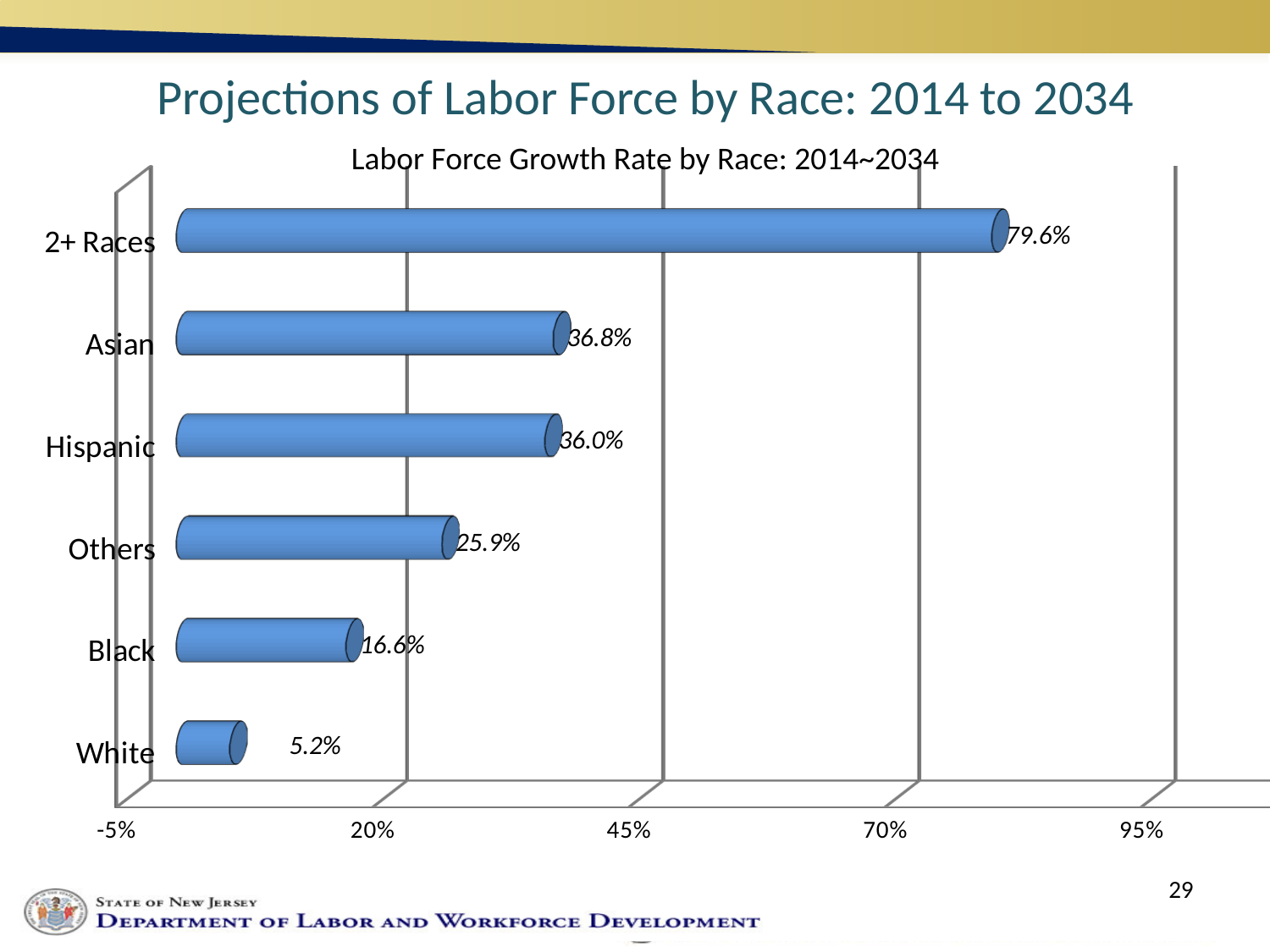
Which race category has the lowest labor force growth rate? White What is the labor force growth rate for Asian? 36.8% How many race categories are shown in the chart? 6 What kind of chart is shown on the slide? Bar chart What is the title of the chart? Labor Force Growth Rate by Race: 2014~2034 Which race category has the highest labor force growth rate? 2+ Races What is the labor force growth rate for White? 5.2% What is the difference between the growth rates for Others and Black? 9.3% What is the labor force growth rate for Black? 16.6% What is the labor force growth rate for 2+ Races? 79.6% What is the difference between the growth rates for 2+ Races and Asian? 42.8% Which has a larger growth rate, Hispanic or Others? Hispanic